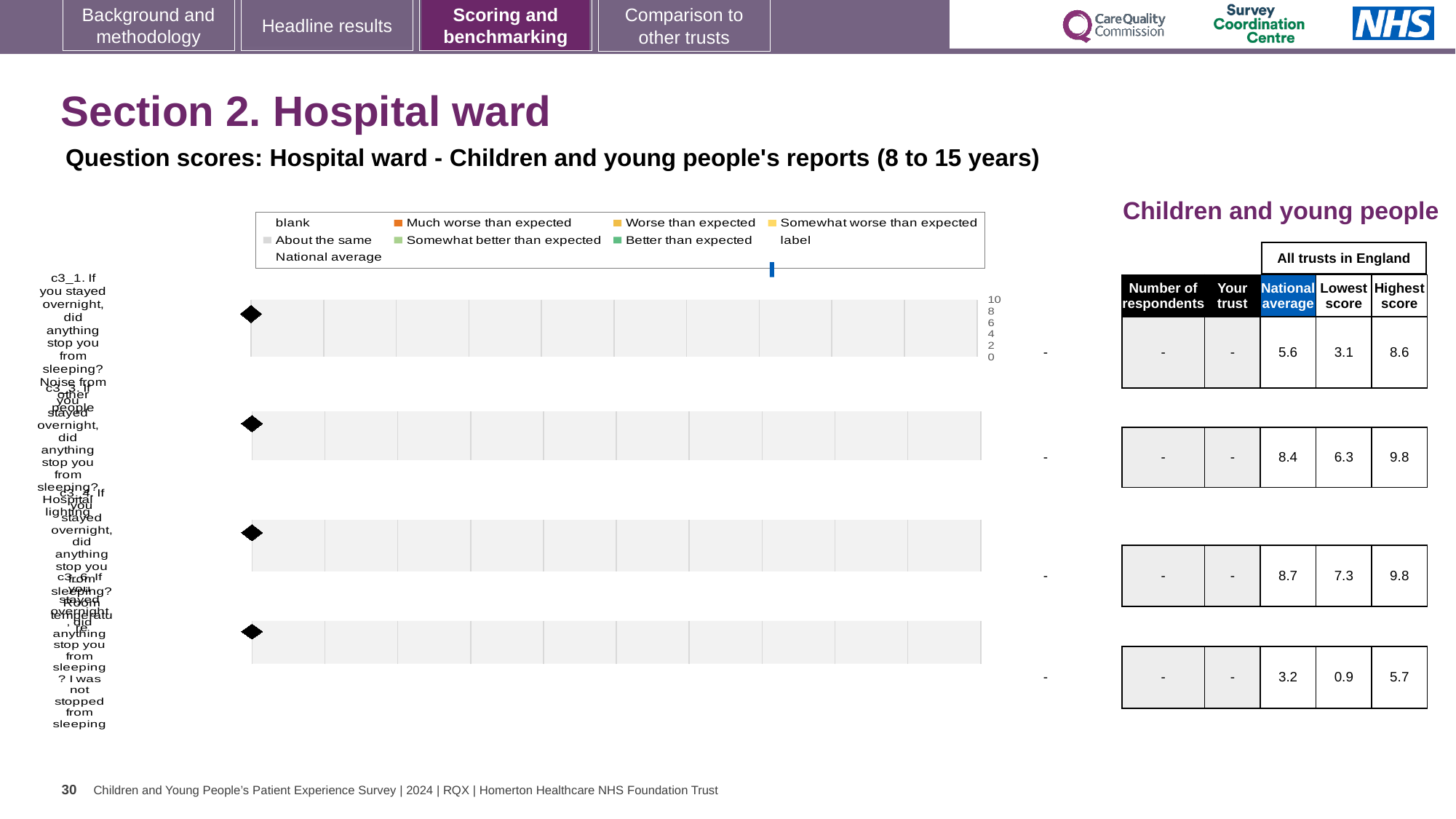
What kind of chart is used for the question scores on this slide? bar chart In the table beside the charts, what is the Highest score for c3_4 (Room temperature)? 9.8 Which question has the lowest National average in the table beside the charts? c3_6 (I was not stopped from sleeping) Which question has the highest National average in the table beside the charts? c3_4 (Room temperature) Is the National average for c3_3 (Hospital lighting) or c3_4 (Room temperature) larger in the table? c3_4 (Room temperature) In the table beside the charts, what is the National average for c3_6 (I was not stopped from sleeping)? 3.2 In the table beside the charts, what is the Lowest score for c3_3 (Hospital lighting)? 6.3 How many charts are shown on the slide? 4 What is the highest value shown on the vertical axis of the charts? 10 Which legend entry is shown with an orange marker? Much worse than expected What is the difference between the Highest score and the Lowest score for c3_3 (Hospital lighting) in the table? 3.5 In the table beside the charts, what is the National average for c3_1 (Noise from other people)? 5.6